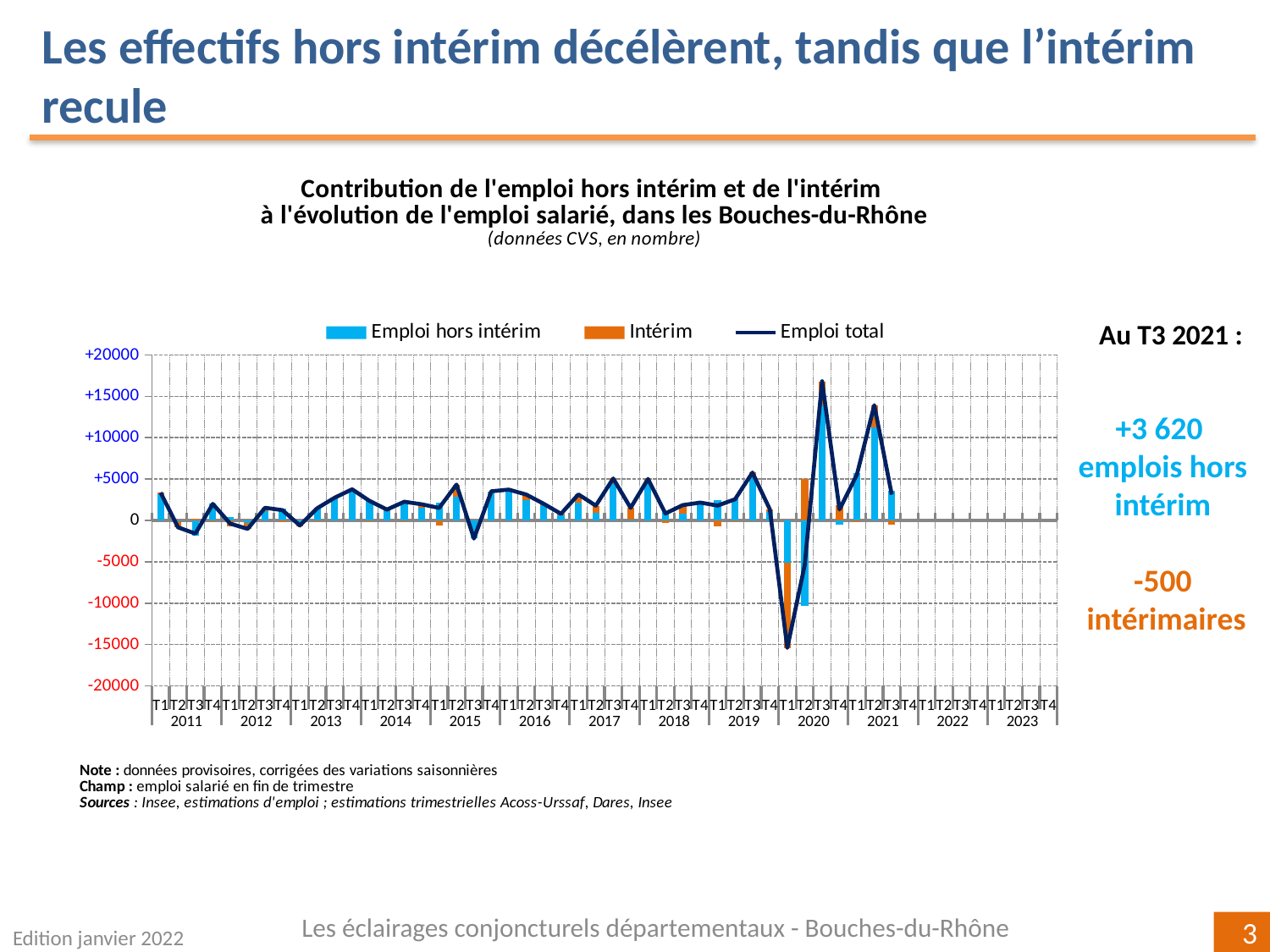
What kind of chart is shown on the slide? bar chart with a line What is the value for Emploi hors intérim at T3 2021? +3 620 In which year does the Emploi total line reach its lowest point? 2020 What are the three series named in the chart legend? Emploi hors intérim, Intérim, Emploi total Is the lowest value of the Emploi total line greater or less than -10000? less At T3 2021, which is larger, the Emploi hors intérim value or the Intérim value? Emploi hors intérim What is the difference between the Emploi hors intérim value (+3 620) and the Intérim value (-500) at T3 2021? 4 120 How many series does the chart legend list? 3 Is the highest value of the Emploi total line greater or less than 10000? greater What is the value for Intérim at T3 2021? -500 In which year does the Emploi total line reach its highest point? 2020 How many years are labelled along the x axis of the chart? 13